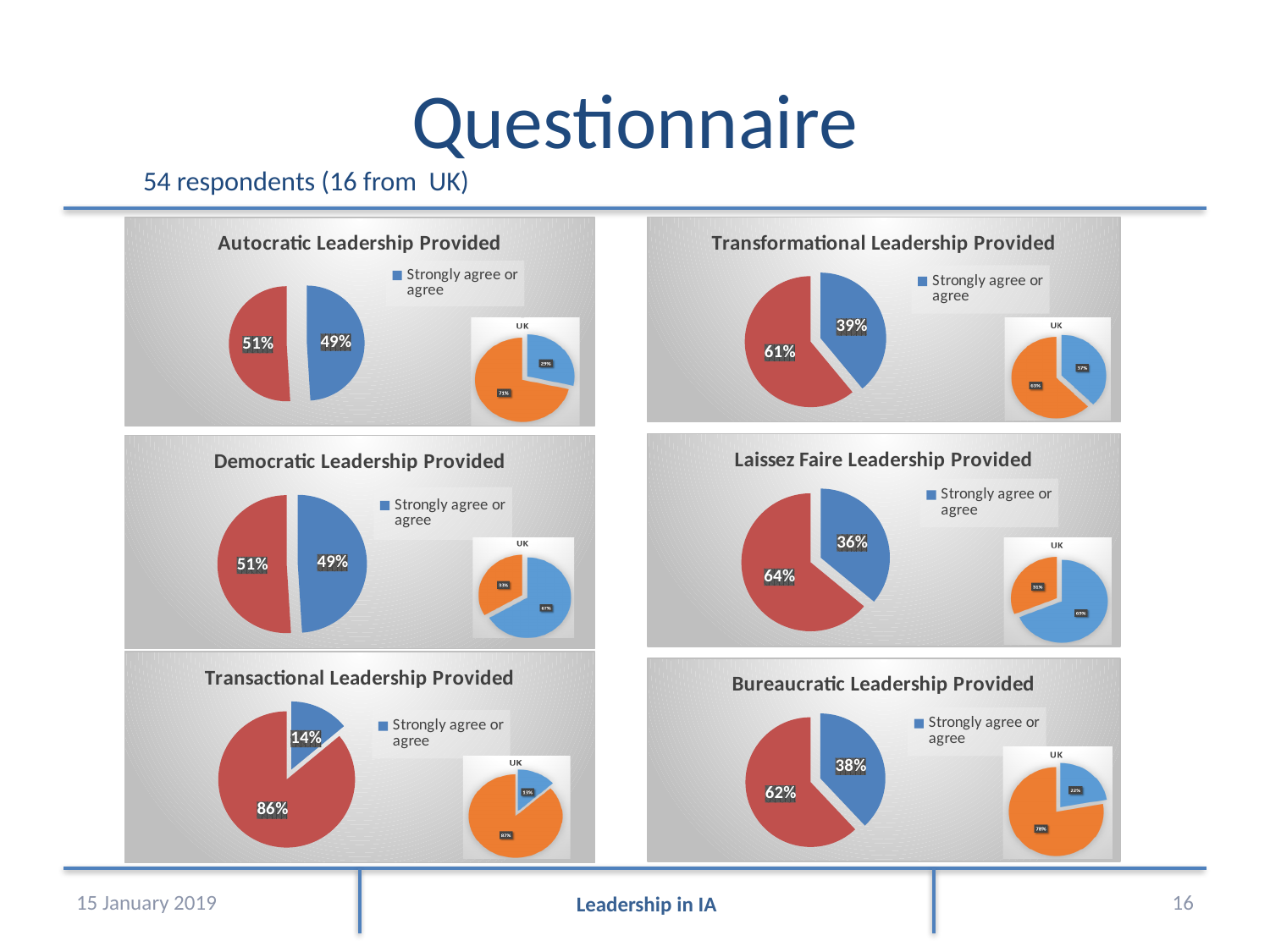
In the Laissez Faire Leadership Provided chart, which slice is larger, the blue slice or the red slice? The red slice In the Transactional Leadership Provided chart, what percentage is shown on the blue slice? 14% In the Bureaucratic Leadership Provided chart, what percentage is shown on the blue slice? 38% In the Democratic Leadership Provided chart, what percentage is shown on the red slice? 51% How many entries does the legend of the Autocratic Leadership Provided chart list? 1 In the Transactional Leadership Provided chart, what is the difference between the red slice and the blue slice? 72% What is the legend entry shown in the Democratic Leadership Provided chart? Strongly agree or agree In the Laissez Faire Leadership Provided chart, what percentage is shown on the red slice? 64% In the Autocratic Leadership Provided chart, what share of respondents strongly agree or agree (the blue slice)? 49% How many slices does the main pie in the Bureaucratic Leadership Provided chart have? 2 What type of chart is used for the Transactional Leadership Provided chart? Pie chart In the Transformational Leadership Provided chart, what percentage is shown on the blue slice? 39%